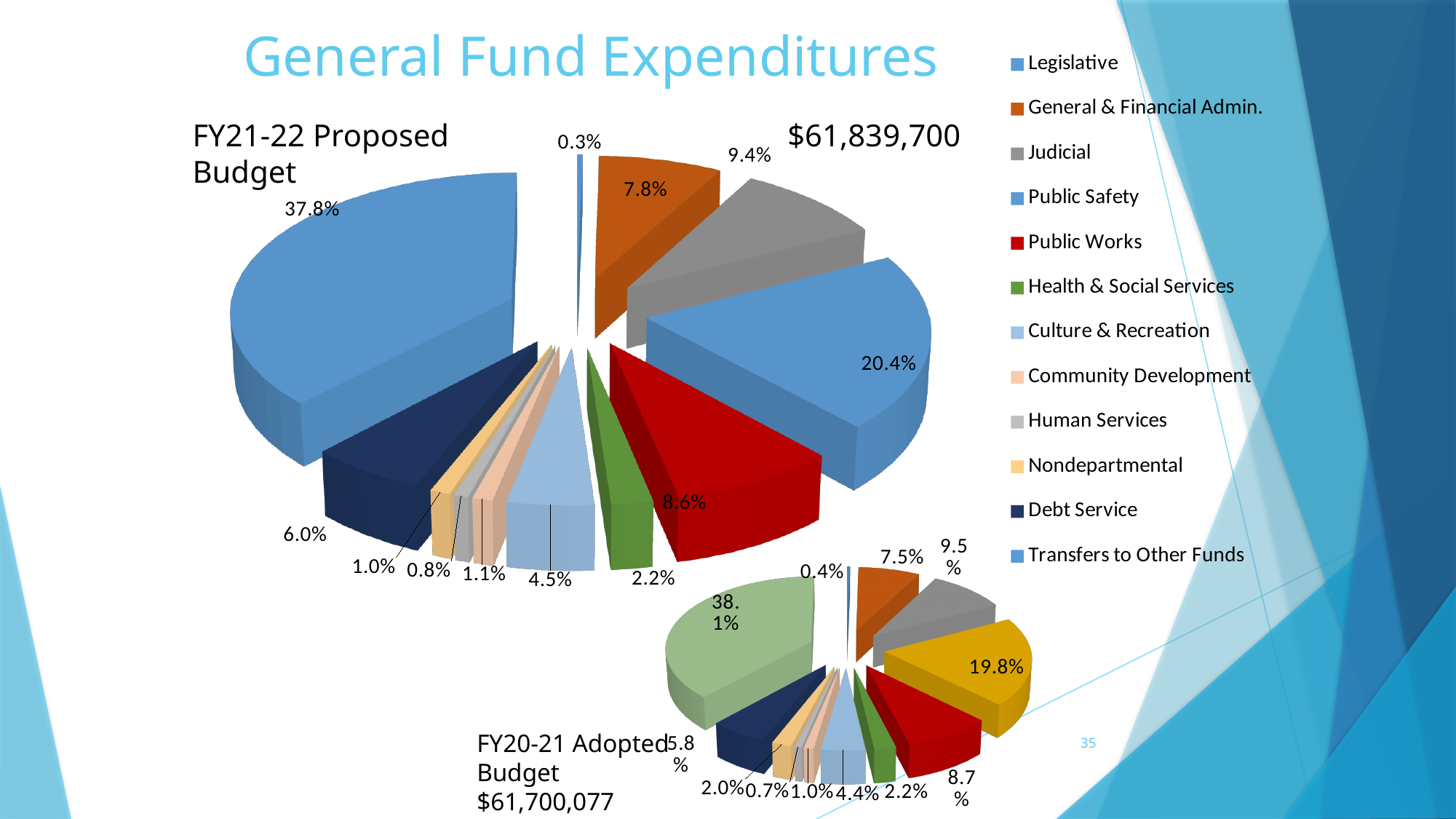
In the FY21-22 Proposed Budget chart, which category has the smallest share? Legislative What total amount is shown for the FY21-22 Proposed Budget? $61,839,700 In the FY21-22 Proposed Budget chart, what percentage is Transfers to Other Funds? 37.8% In the FY21-22 Proposed Budget chart, what percentage is Debt Service? 6.0% In the FY21-22 Proposed Budget chart, how many percentage points larger is Public Safety than Public Works? 11.8 percentage points In the FY20-21 Adopted Budget chart, what percentage is the largest slice? 38.1% How many categories does the legend list? 12 What kind of charts are shown on the slide? Pie charts In the FY21-22 Proposed Budget chart, which category has the largest share? Transfers to Other Funds In the FY20-21 Adopted Budget chart, what percentage is Public Safety? 19.8% In the FY21-22 Proposed Budget chart, what percentage is Public Safety? 20.4% In the FY21-22 Proposed Budget chart, which is larger: Judicial or General & Financial Admin.? Judicial